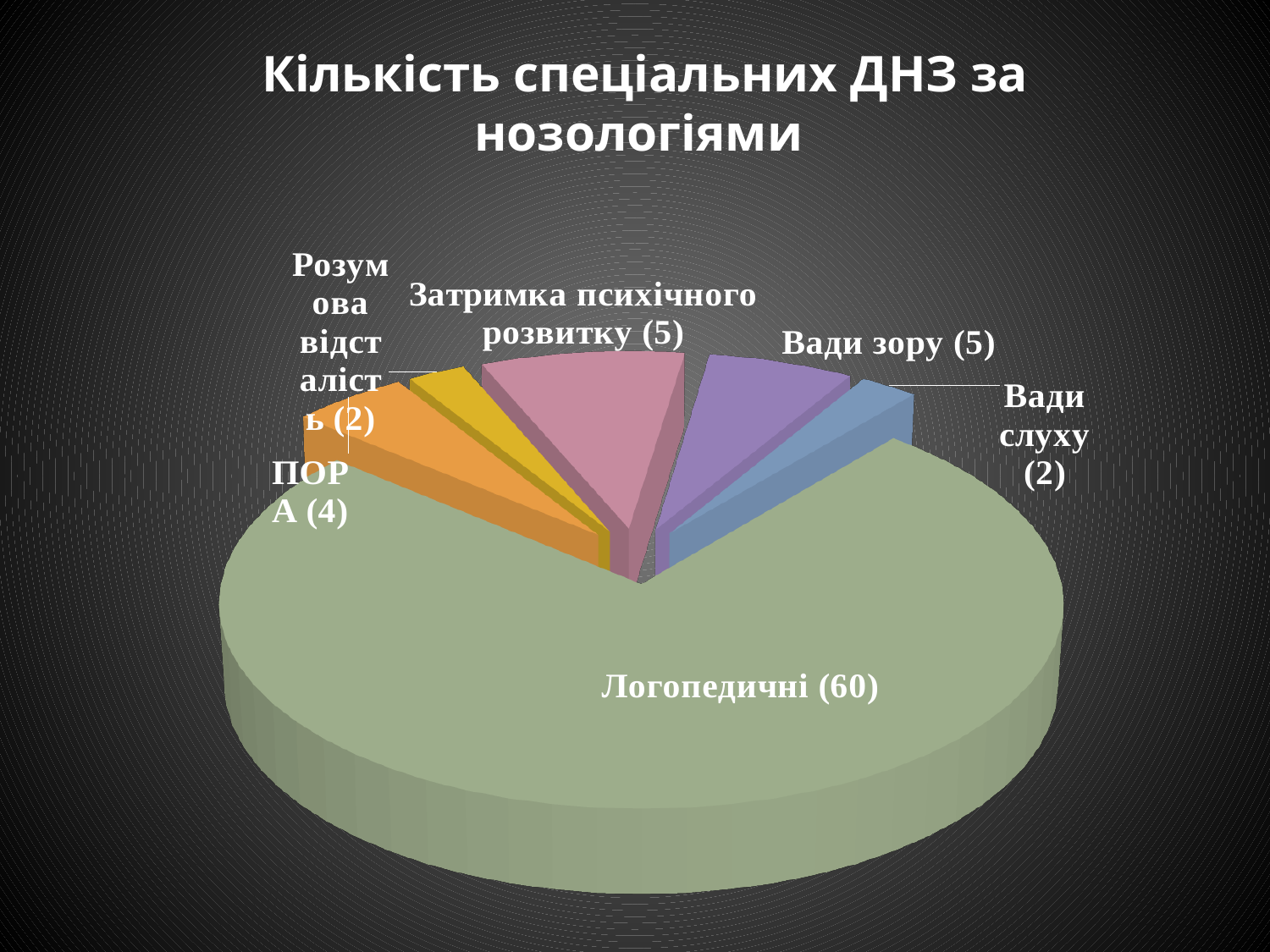
What is the value for Затримка психічного розвитку? 5 What is the value for Вади слуху? 2 What is the value for ПОРА? 4 What kind of chart is shown on the slide? Pie chart What is the title of the chart? Кількість спеціальних ДНЗ за нозологіями Which category has the largest slice of the pie? Логопедичні What is the total of all the values shown in the pie chart? 78 What is the difference between the values for Логопедичні and Вади зору? 55 What is the value for Вади зору? 5 How many categories (slices) does the pie chart have? 6 What is the value for Логопедичні? 60 Which is larger, the value for ПОРА or the value for Розумова відсталість? ПОРА